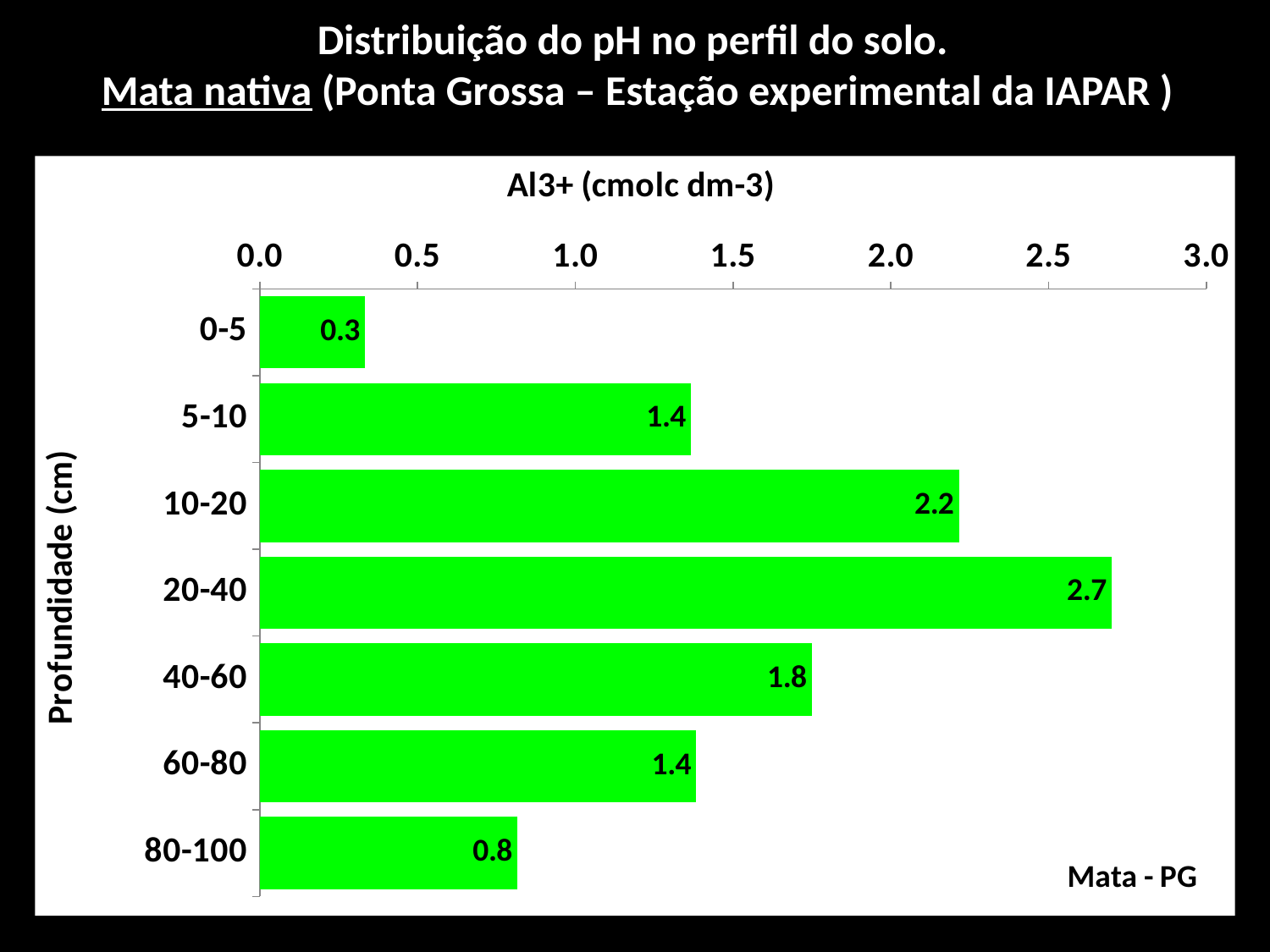
Which depth has the lowest Al3+ value? 0-5 What is the Al3+ value for the 20-40 cm depth? 2.7 How many depth categories are shown in the chart? 7 What is the Al3+ value for the 0-5 cm depth? 0.3 What kind of chart is shown on the slide? Bar chart Which depth has the highest Al3+ value? 20-40 Which depth has a larger Al3+ value, 40-60 or 60-80? 40-60 What is the Al3+ value for the 40-60 cm depth? 1.8 What is the Al3+ value for the 80-100 cm depth? 0.8 What is the difference between the Al3+ values for 20-40 cm and 10-20 cm? 0.5 What is the label on the vertical axis of the chart? Profundidade (cm) Is the Al3+ value for 10-20 cm greater or less than 2.0? greater